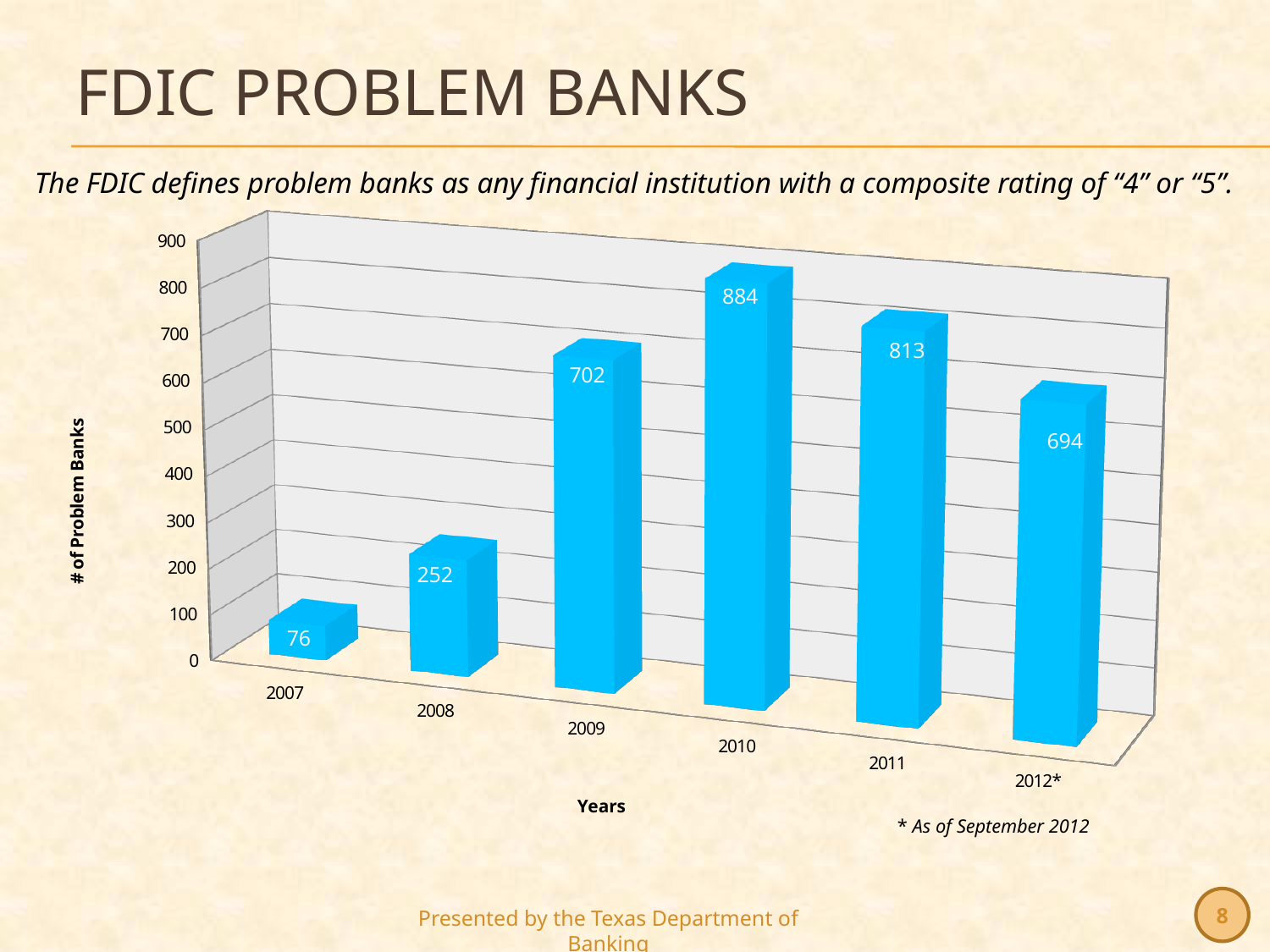
How many FDIC problem banks were there in 2009? 702 Is the value for 2008 greater or less than 300? less What is the number of problem banks shown for 2012*? 694 Which year had more problem banks, 2009 or 2012*? 2009 Which year has the lowest number of problem banks? 2007 Which year has the highest number of problem banks? 2010 How many years are shown on the x axis of the chart? 6 What kind of chart is shown on the slide? bar chart What is the label of the vertical axis of the chart? # of Problem Banks By how much did the number of problem banks increase from 2007 to 2008? 176 Do the values rise or fall from 2007 to 2010? rise What is the difference between the number of problem banks in 2010 and in 2011? 71